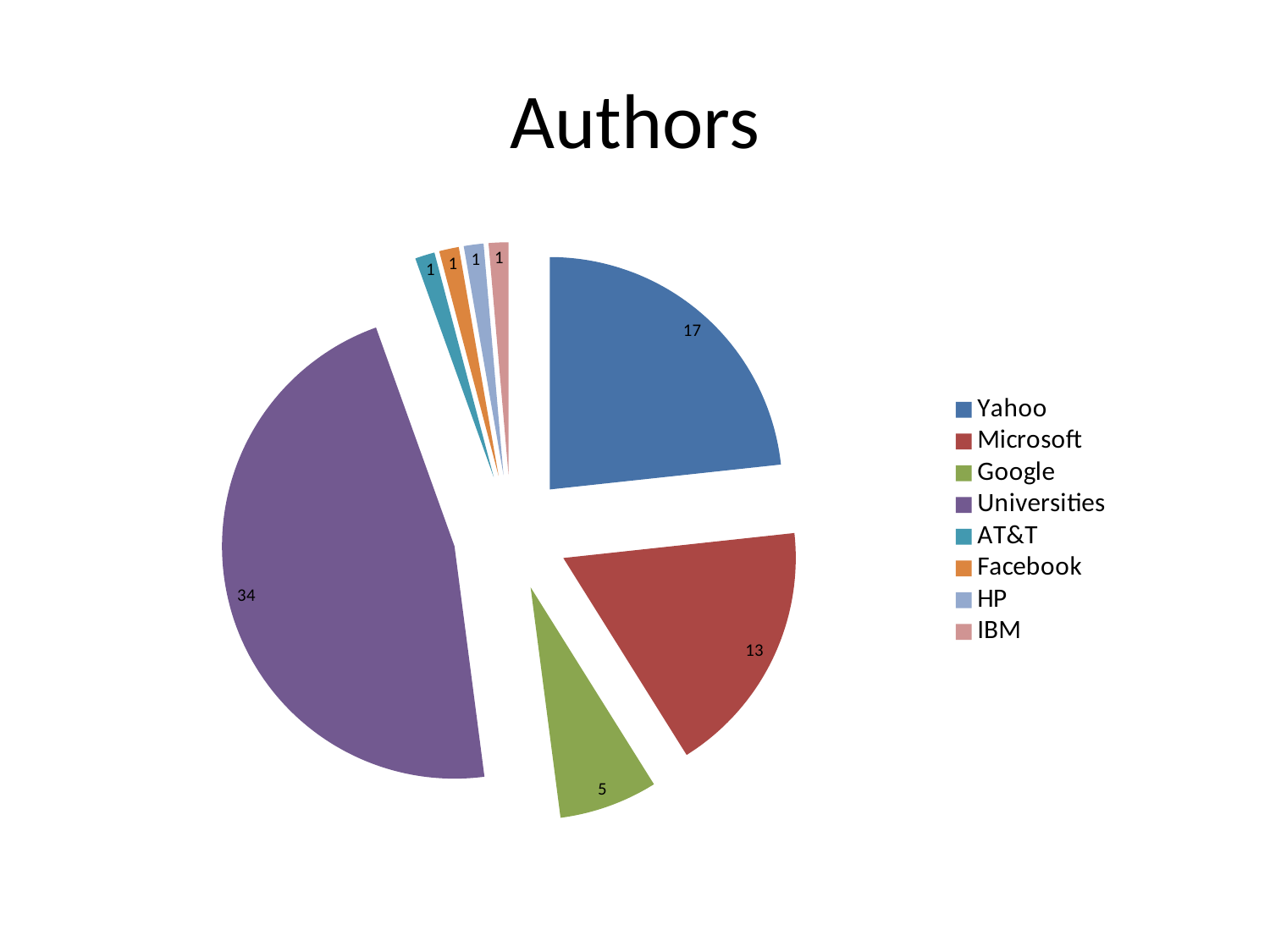
What is the value for Universities? 34 What is the value for Yahoo? 17 Which is larger, the value for Microsoft or the value for Google? Microsoft What is the value for Facebook? 1 What is the difference between the values for Universities and Yahoo? 17 Which category has the largest slice? Universities What is the title of the chart? Authors What is the value for Google? 5 How many slices does the pie chart have? 8 What is the value for Microsoft? 13 What type of chart is shown on the slide? pie chart What is the total of all the slices in the pie chart? 73